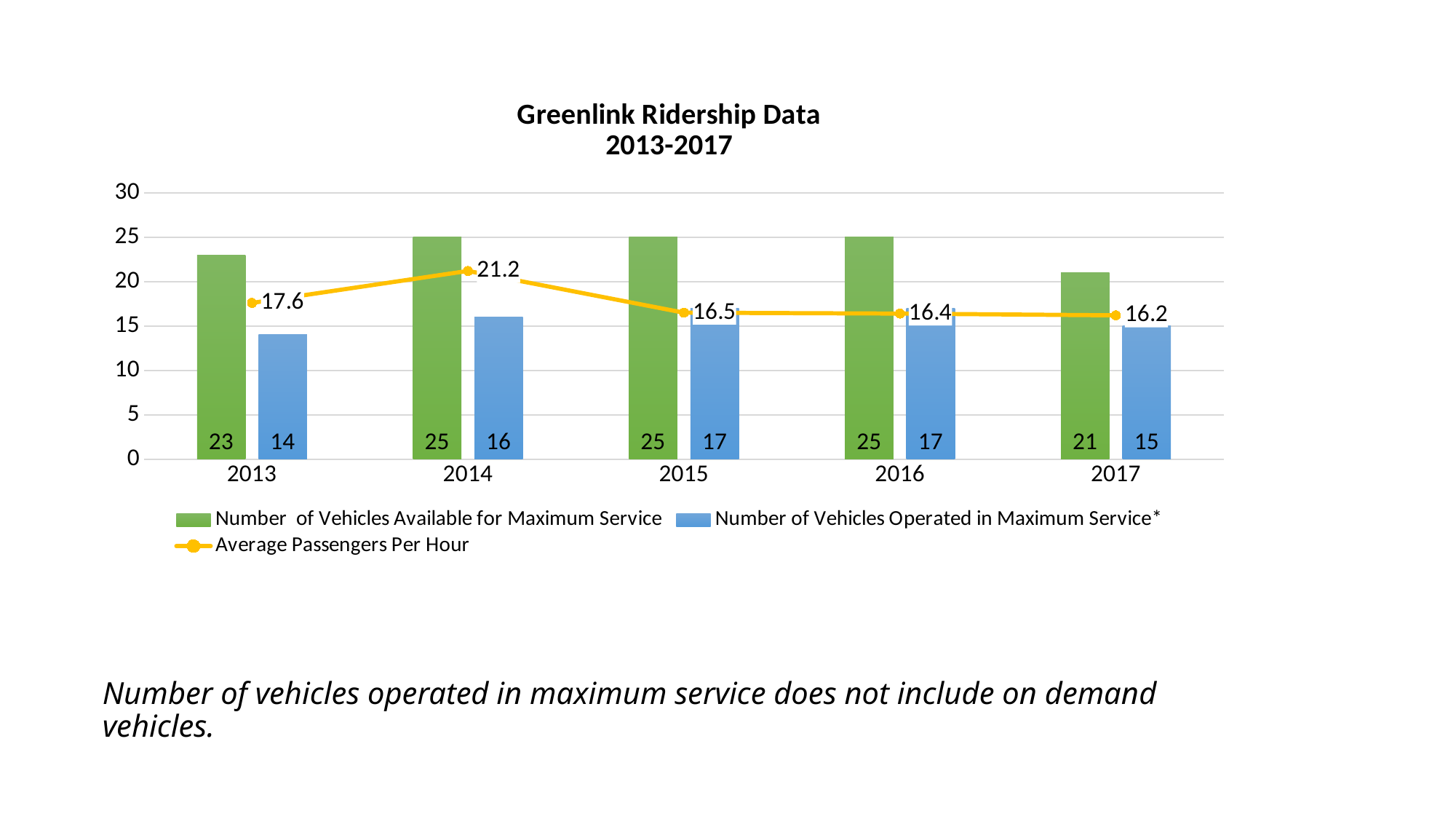
In which year is the Average Passengers Per Hour highest? 2014 Which is larger: the Average Passengers Per Hour in 2013 or in 2017? 2013 What is the difference between the Number of Vehicles Available for Maximum Service and the Number of Vehicles Operated in Maximum Service in 2014? 9 How many series does the legend list? 3 What is the Number of Vehicles Operated in Maximum Service in 2016? 17 How many years are shown on the x axis? 5 In which year is the Number of Vehicles Operated in Maximum Service lowest? 2013 What is the Average Passengers Per Hour in 2014? 21.2 What kind of chart is used for the Number of Vehicles Available for Maximum Service series? Bar chart What is the Number of Vehicles Available for Maximum Service in 2013? 23 Does the Average Passengers Per Hour rise or fall from 2014 to 2017? Fall What is the title of the chart? Greenlink Ridership Data 2013-2017